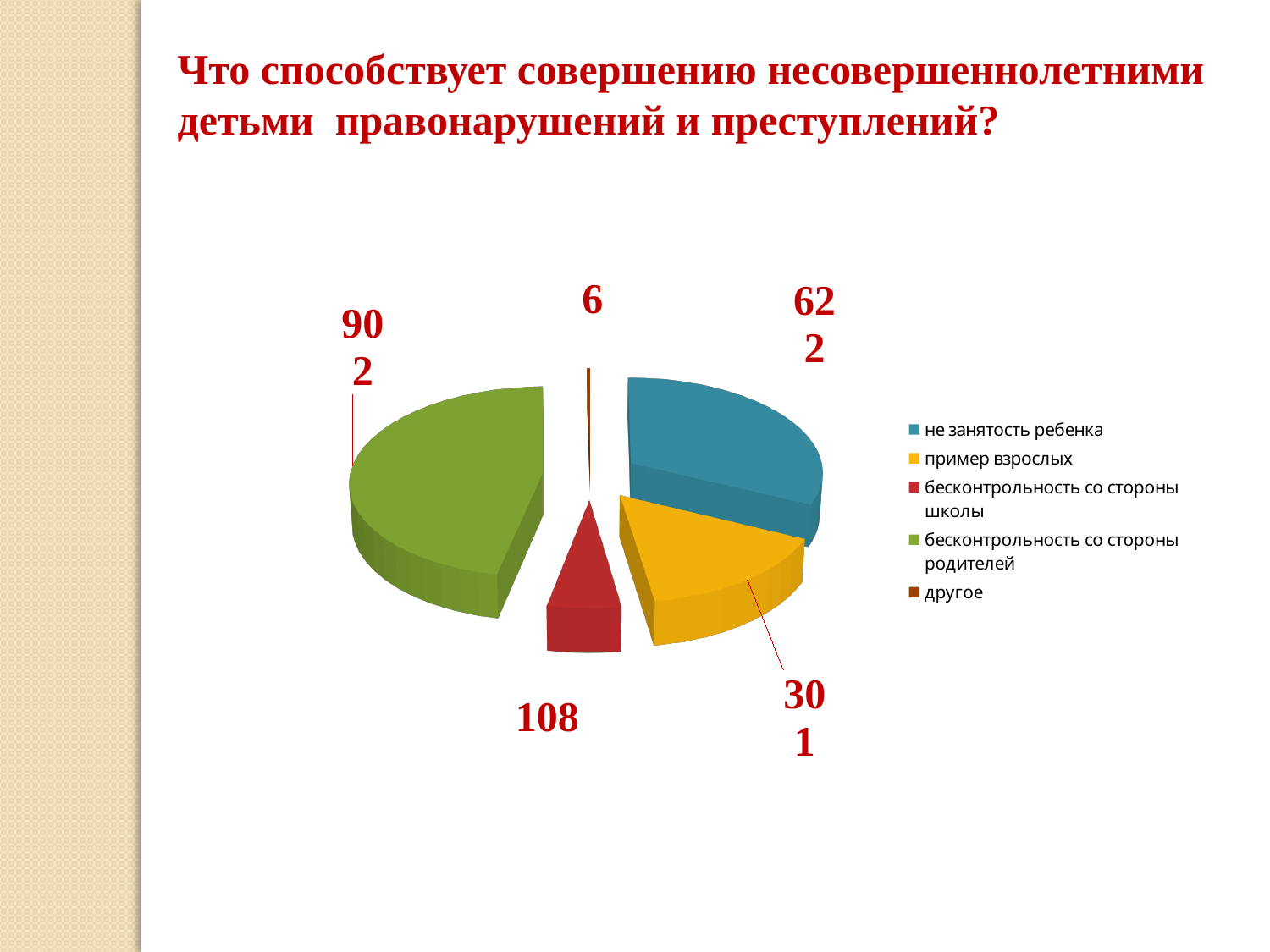
Which is larger, 'не занятость ребенка' or 'пример взрослых'? не занятость ребенка What is the value for 'другое'? 6 How many categories does the legend of the pie chart list? 5 Which category has the largest slice of the pie? бесконтрольность со стороны родителей Which category has the smallest slice of the pie? другое What type of chart is shown on the slide? pie chart What is the value for 'бесконтрольность со стороны школы'? 108 What is the value for 'пример взрослых'? 301 What colour is the slice for 'бесконтрольность со стороны школы'? red What is the value for 'не занятость ребенка'? 622 What is the difference between the values for 'бесконтрольность со стороны родителей' and 'не занятость ребенка'? 280 What is the value for 'бесконтрольность со стороны родителей'? 902